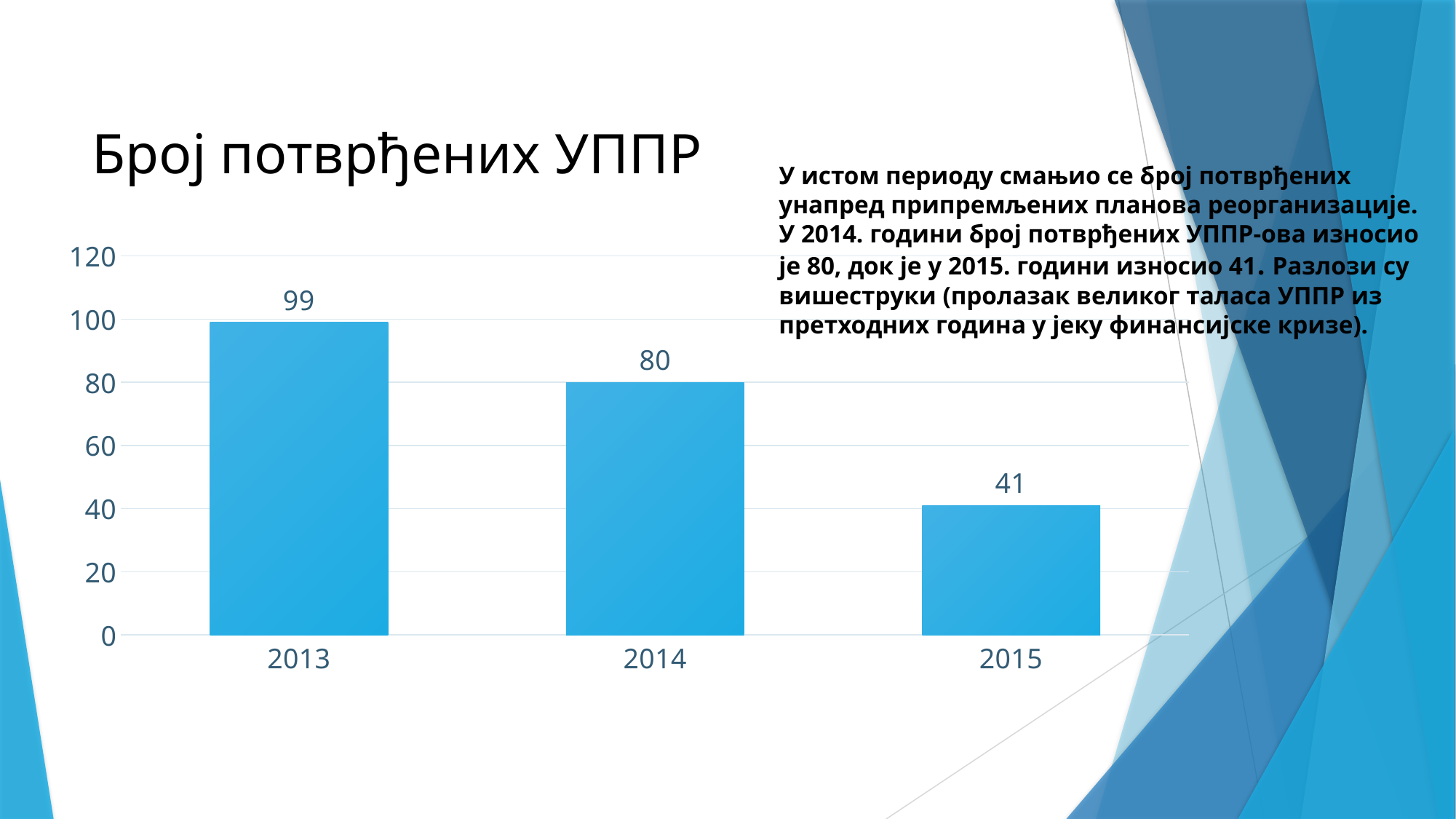
Do the values rise or fall from 2013 to 2015? fall Is the value for 2015 greater or less than 60? less What is the value for 2014? 80 Which year has the highest value? 2013 What is the difference between the values for 2014 and 2015? 39 What is the value for 2015? 41 What is the difference between the values for 2013 and 2015? 58 What is the value for 2013? 99 What kind of chart is shown on the slide? bar chart How many years are shown on the chart? 3 Which is larger, the value for 2013 or the value for 2014? 2013 Which year has the lowest value? 2015